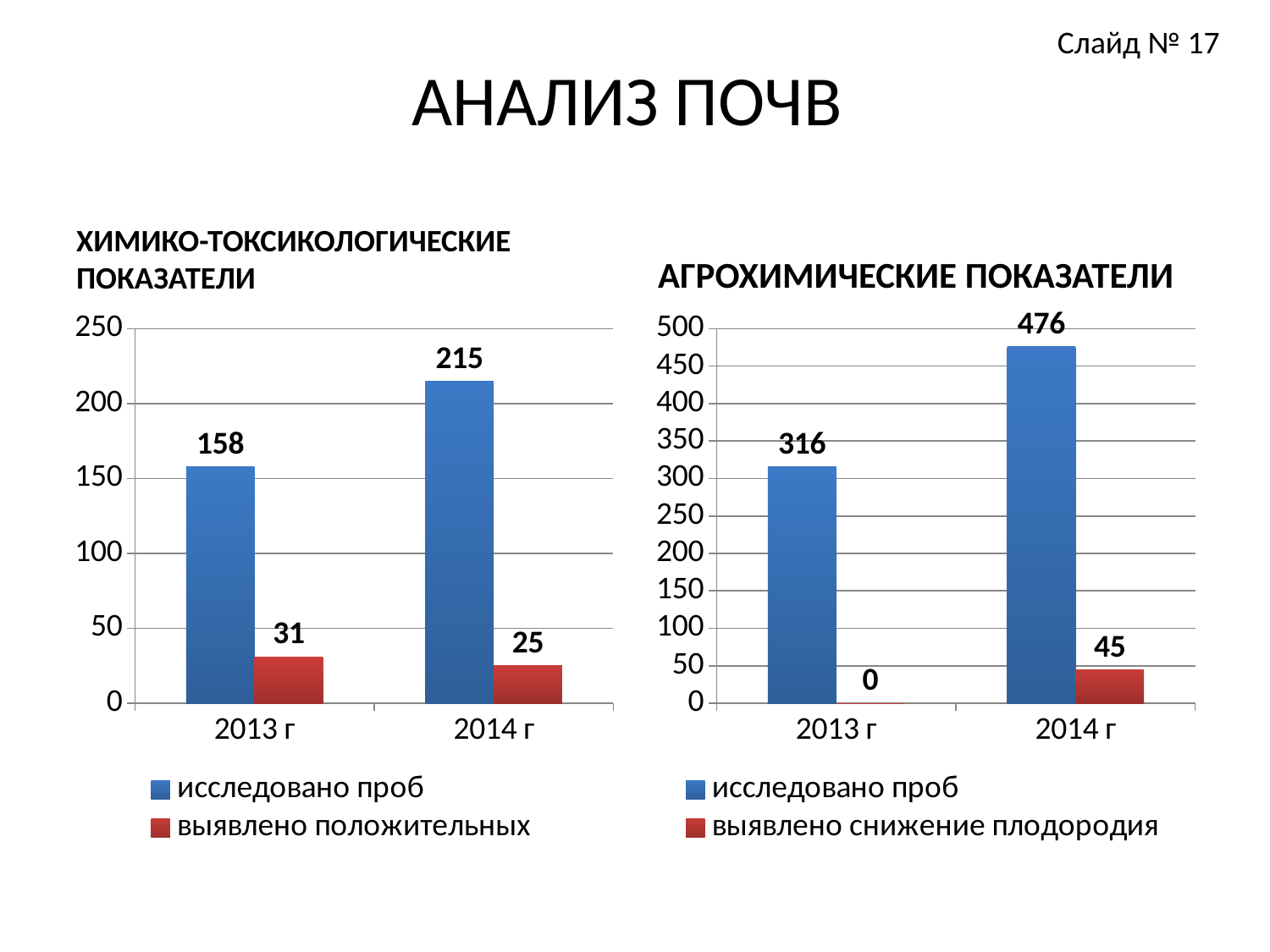
In the 'ХИМИКО-ТОКСИКОЛОГИЧЕСКИЕ ПОКАЗАТЕЛИ' chart, what is the value of 'исследовано проб' for 2013 г? 158 How many year categories are shown on the x axis of the 'АГРОХИМИЧЕСКИЕ ПОКАЗАТЕЛИ' chart? 2 In the 'ХИМИКО-ТОКСИКОЛОГИЧЕСКИЕ ПОКАЗАТЕЛИ' chart, by how much did 'исследовано проб' increase from 2013 г to 2014 г? 57 What kind of chart is the 'ХИМИКО-ТОКСИКОЛОГИЧЕСКИЕ ПОКАЗАТЕЛИ' chart? bar chart In the 'АГРОХИМИЧЕСКИЕ ПОКАЗАТЕЛИ' chart, what is the value of 'исследовано проб' for 2014 г? 476 In the 'АГРОХИМИЧЕСКИЕ ПОКАЗАТЕЛИ' chart, what is the value of 'выявлено снижение плодородия' for 2013 г? 0 In the 'ХИМИКО-ТОКСИКОЛОГИЧЕСКИЕ ПОКАЗАТЕЛИ' chart, does 'исследовано проб' rise or fall from 2013 г to 2014 г? rise In the 'АГРОХИМИЧЕСКИЕ ПОКАЗАТЕЛИ' chart, what is the difference between 'исследовано проб' in 2014 г and 2013 г? 160 In the 'ХИМИКО-ТОКСИКОЛОГИЧЕСКИЕ ПОКАЗАТЕЛИ' chart, which year has the higher value of 'выявлено положительных'? 2013 г In the 'АГРОХИМИЧЕСКИЕ ПОКАЗАТЕЛИ' chart, which year has the highest value of 'исследовано проб'? 2014 г How many series does the legend of the 'АГРОХИМИЧЕСКИЕ ПОКАЗАТЕЛИ' chart list? 2 In the 'ХИМИКО-ТОКСИКОЛОГИЧЕСКИЕ ПОКАЗАТЕЛИ' chart, what is the value of 'выявлено положительных' for 2014 г? 25